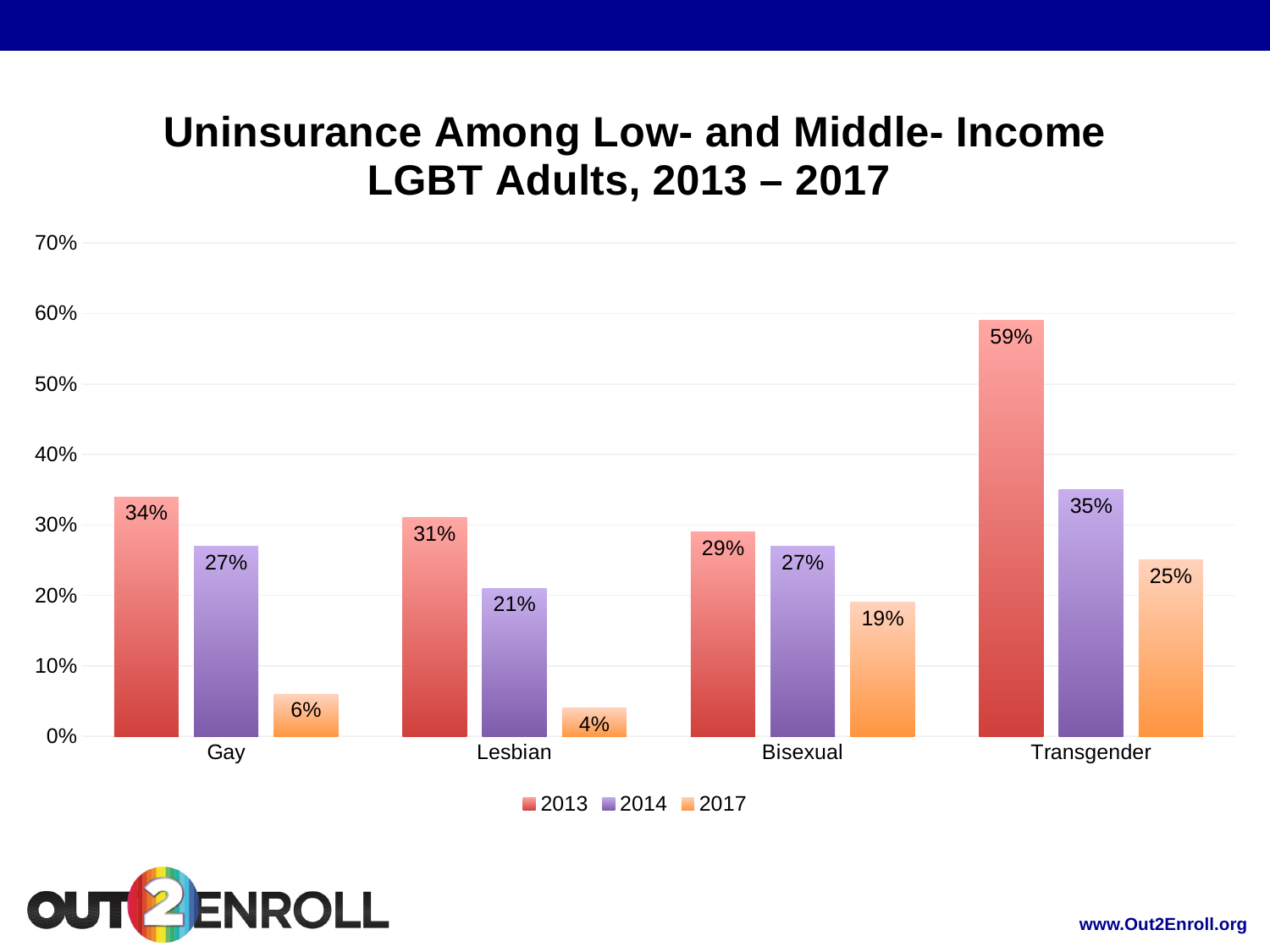
What is the uninsurance rate for Bisexual adults in 2014? 27% Is the 2013 uninsurance rate for Transgender adults greater or less than 50%? greater Which category has the lowest uninsurance rate in 2017? Lesbian What kind of chart is shown on the slide? Bar chart How many series does the legend list? 3 What is the uninsurance rate for Lesbian adults in 2017? 4% Which category has the highest uninsurance rate in 2013? Transgender Which is larger: the 2014 uninsurance rate for Gay adults or for Lesbian adults? Gay What is the uninsurance rate for Transgender adults in 2013? 59% How many categories are shown on the x axis? 4 Which year does the orange series in the legend represent? 2017 What is the difference between the 2013 and 2017 uninsurance rates for Gay adults? 28 percentage points